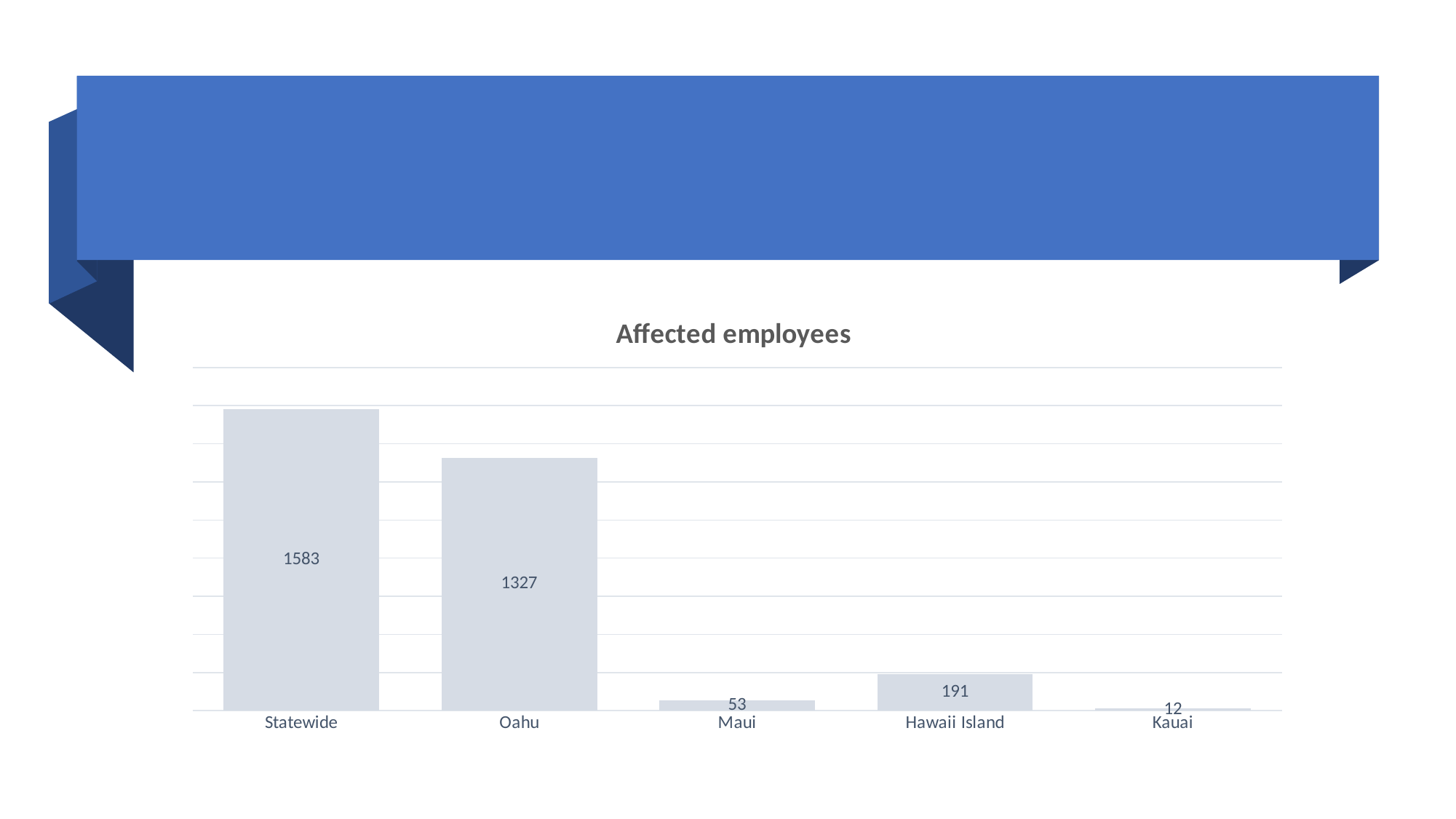
Which category has the lowest value? Kauai Which category has the highest value? Statewide What is the value for Hawaii Island? 191 What is the difference between the Hawaii Island and Maui values? 138 How many affected employees are shown for Oahu? 1327 What type of chart is shown? Bar chart What is the value for Statewide in the Affected employees chart? 1583 What is the difference between the Statewide and Oahu values? 256 What is the value for Maui? 53 How many categories are shown on the x axis? 5 What is the value for Kauai? 12 Which is larger, the value for Maui or the value for Hawaii Island? Hawaii Island